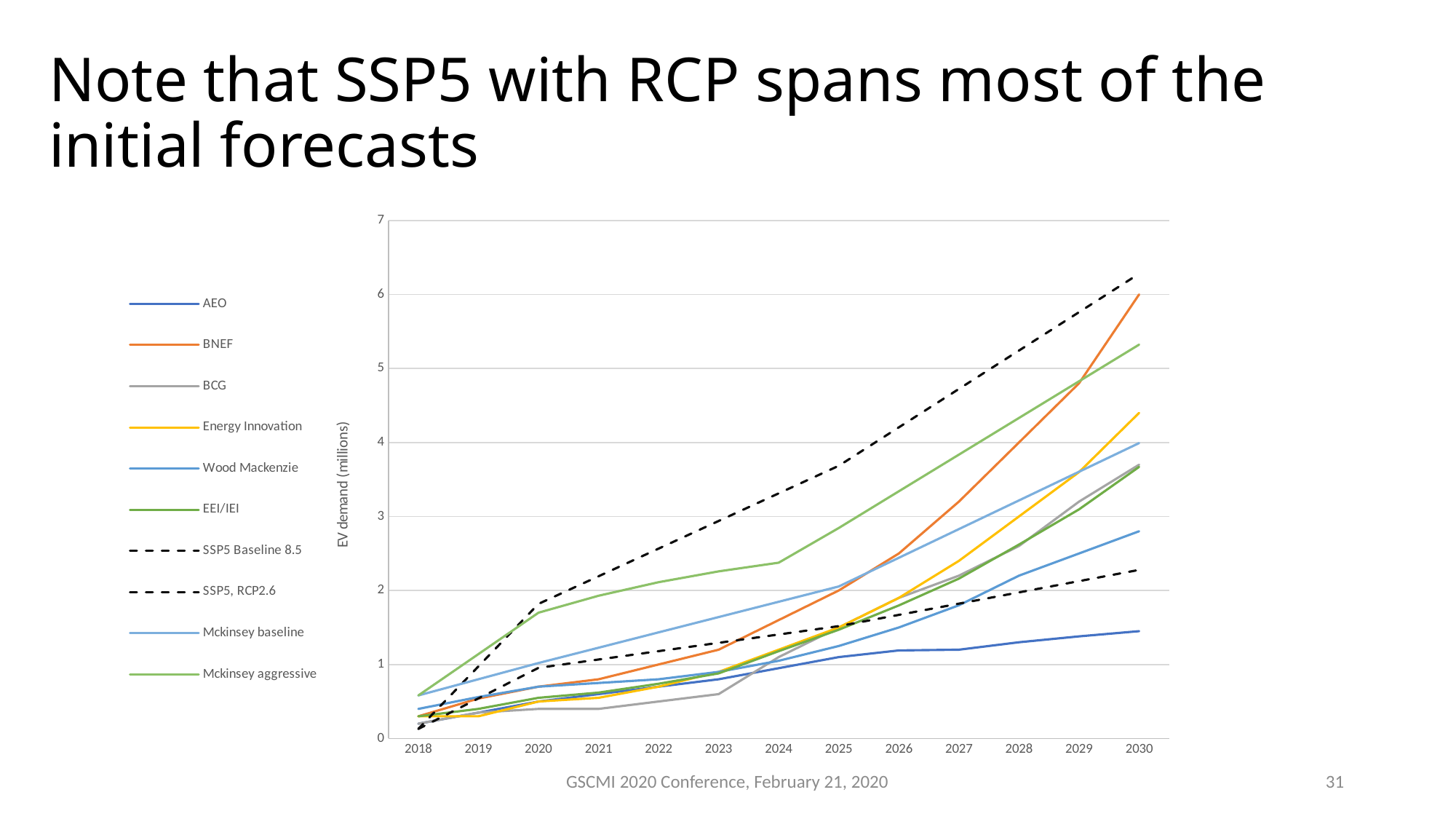
Does the AEO series rise or fall from 2018 to 2030? rise Is the value for AEO in 2030 greater or less than 2? less What kind of chart is shown on the slide? line chart How many years are shown along the x axis? 13 Is the value for Mckinsey aggressive in 2030 greater or less than 5? greater Which two legend entries are drawn as dashed lines? SSP5 Baseline 8.5 and SSP5, RCP2.6 In 2030, which is larger, Energy Innovation or Wood Mackenzie? Energy Innovation What is the label on the vertical axis? EV demand (millions) Among the solid-line series, which has the highest value in 2030? BNEF How many series does the legend list? 10 Which series has the lowest value in 2030? AEO Is the value for Wood Mackenzie in 2030 greater or less than 3? less